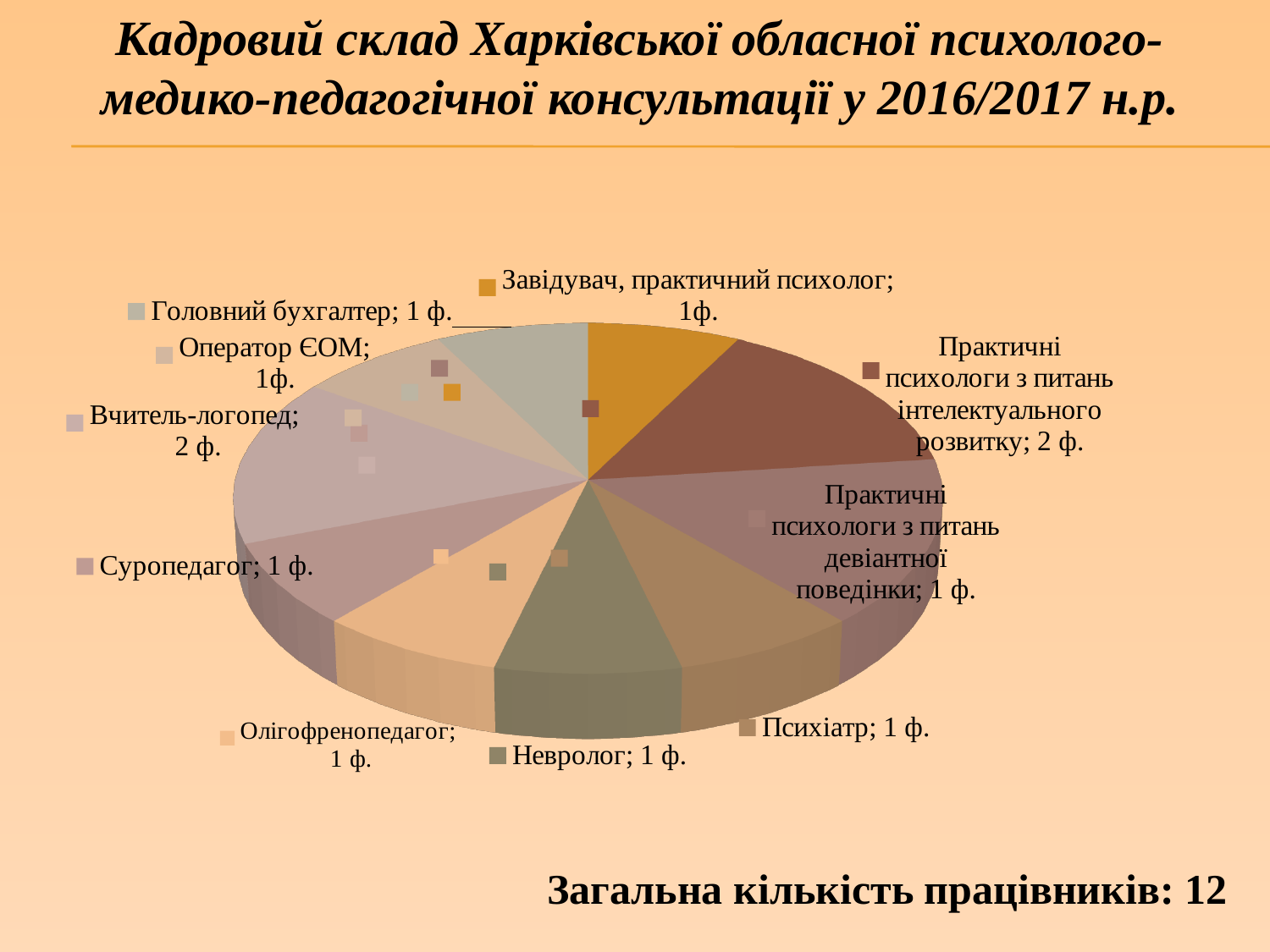
What is the value shown for Практичні психологи з питань інтелектуального розвитку? 2 ф. What fraction of the total staff does Вчитель-логопед represent? 2 of 12 What is the total number of employees stated on the slide? 12 What is the value shown for Невролог? 1 ф. What is the difference between the value for Вчитель-логопед and the value for Психіатр? 1 ф. What is the value shown for Вчитель-логопед? 2 ф. What academic year does the chart title refer to? 2016/2017 н.р. Which is larger, the value for Вчитель-логопед or the value for Суропедагог? Вчитель-логопед What is the value shown for Головний бухгалтер? 1 ф. Which categories have the largest value in the pie chart? Практичні психологи з питань інтелектуального розвитку and Вчитель-логопед How many categories (positions) does the pie chart show? 10 What kind of chart is shown on the slide? pie chart